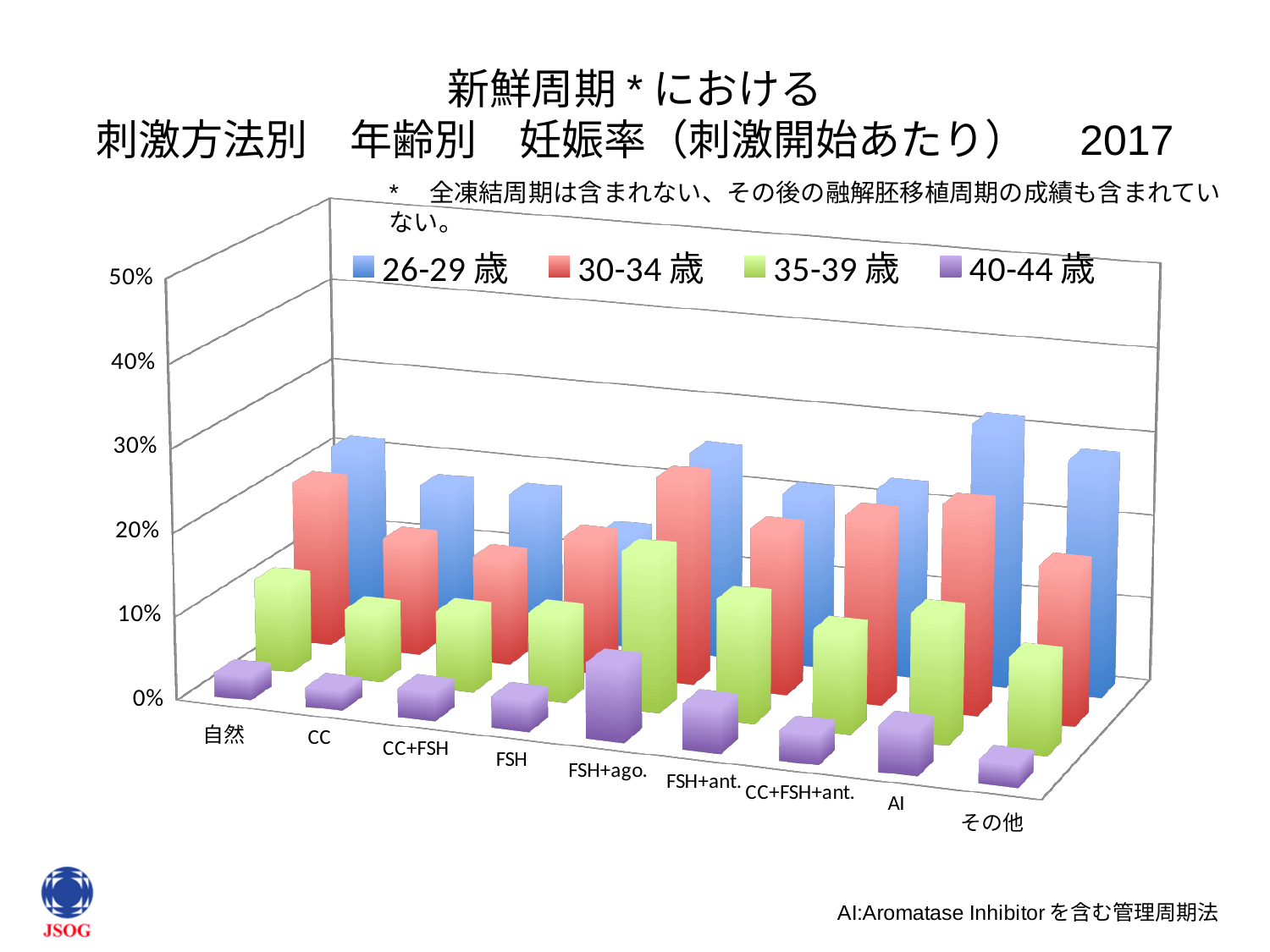
Is the value for 30-34歳 at その他 greater or less than 10%? greater Within the 26-29歳 series, which category has the highest value? AI What kind of chart is shown on the slide? bar chart For 自然, which is larger: the value for 26-29歳 or for 40-44歳? 26-29歳 Which age groups are listed in the legend? 26-29歳, 30-34歳, 35-39歳, 40-44歳 Is the value for 40-44歳 at CC greater or less than 10%? less Within the 35-39歳 series, which category has the highest value? FSH+ago. Which year does the chart title refer to? 2017 How many series does the legend list? 4 How many stimulation-method categories are shown on the x axis? 9 For FSH+ago., which is larger: the value for 35-39歳 or for 40-44歳? 35-39歳